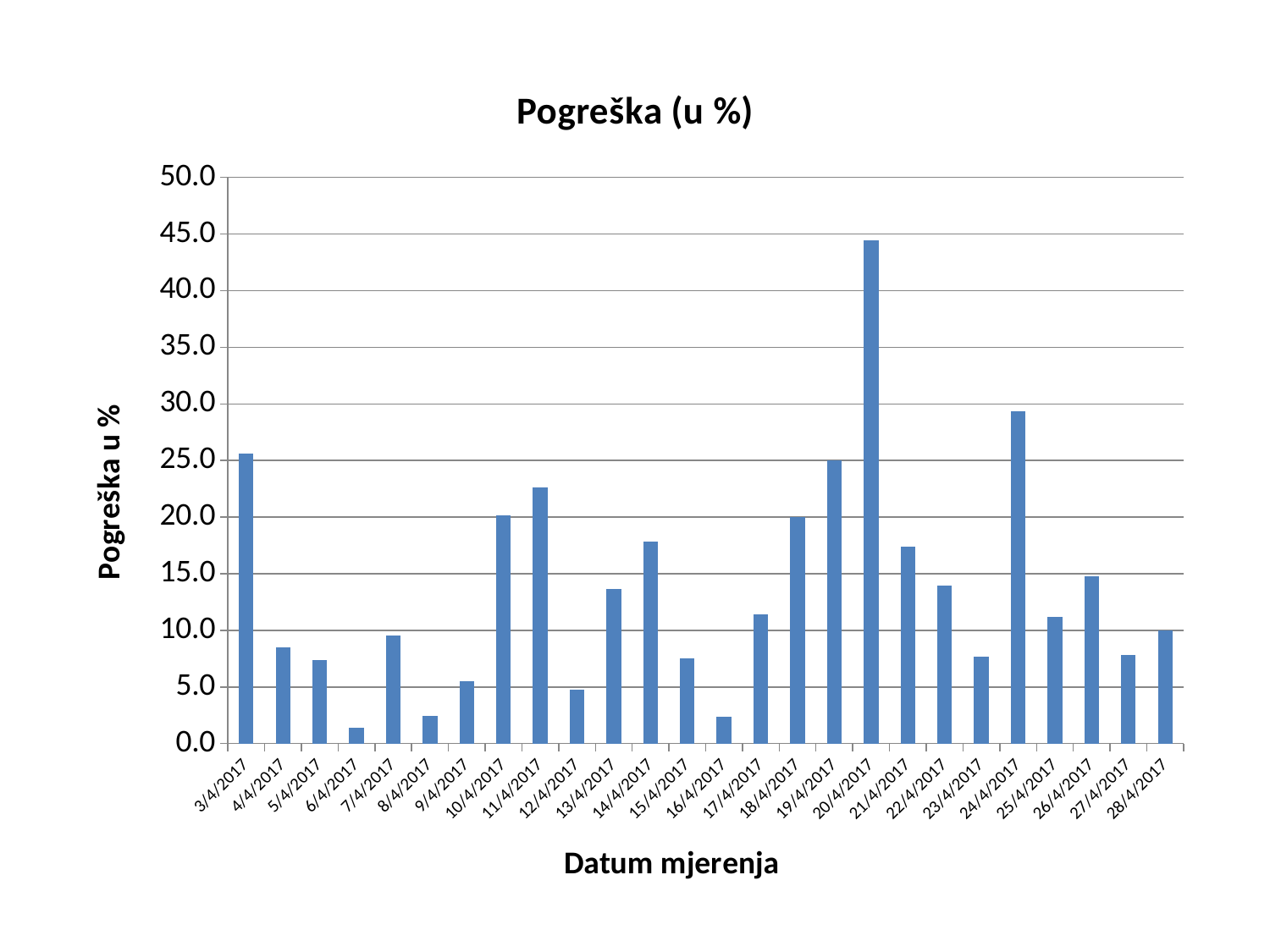
Is the value for 14/4/2017 greater or less than 20.0? less Which has the larger value, 3/4/2017 or 4/4/2017? 3/4/2017 Which has the larger value, 20/4/2017 or 24/4/2017? 20/4/2017 Which date has the highest error value? 20/4/2017 How many dates are plotted on the x axis? 26 Is the value for 20/4/2017 greater or less than 40.0? greater Is the value for 24/4/2017 greater or less than 25.0? greater Which date has the lowest error value? 6/4/2017 What is the title of the chart? Pogreška (u %) What is the label of the x axis? Datum mjerenja What kind of chart is shown on the slide? bar chart